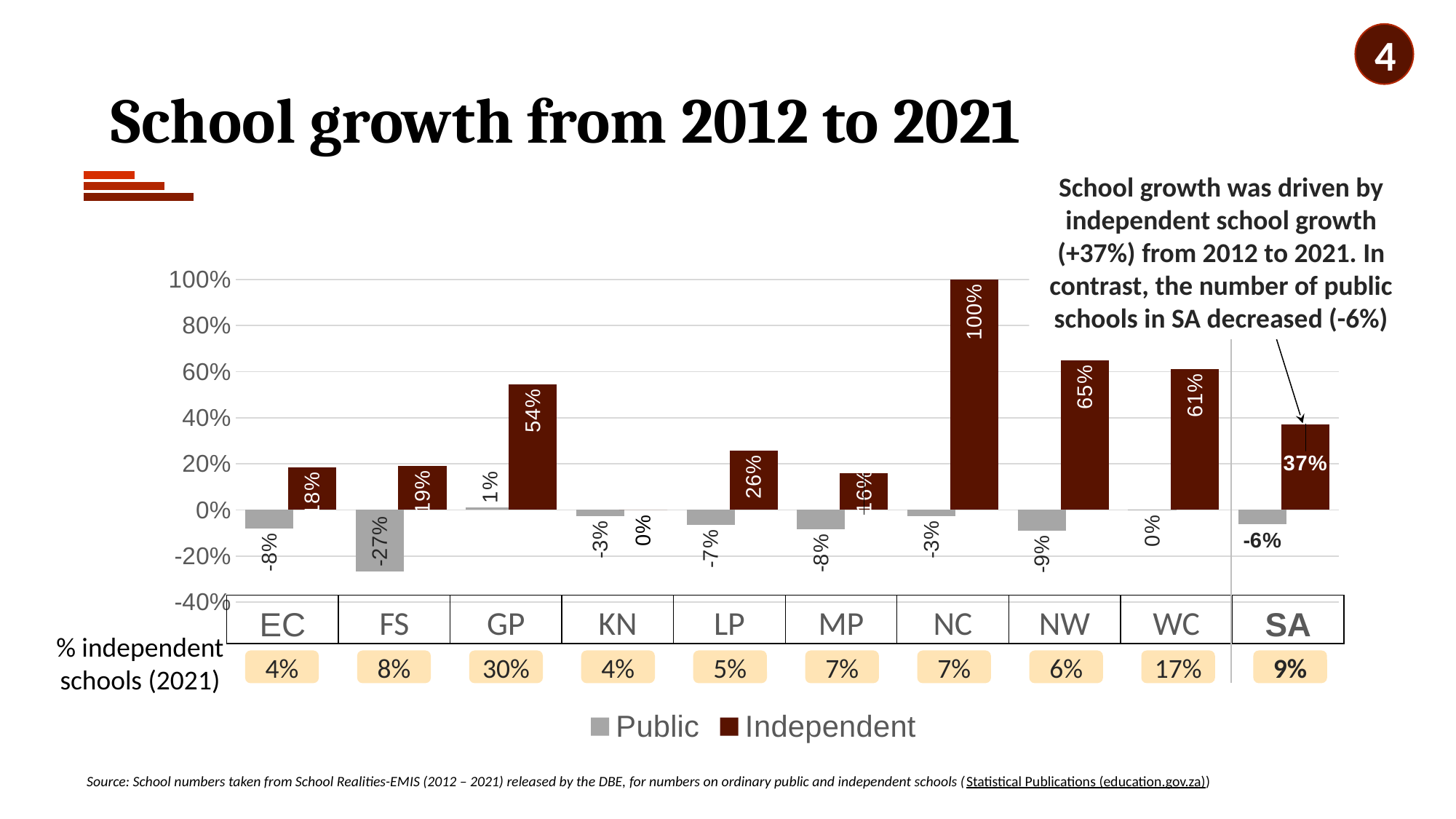
What is the Public value for FS? -27% What is the Public value for SA? -6% What is the Independent value for GP? 54% Which category has the highest Independent value? NC Which has the larger Independent value, GP or LP? GP What is the difference between the Independent values for NW and WC? 4 percentage points How many series does the chart legend list? 2 Which category has the lowest Public value? FS What are the two entries in the chart legend? Public and Independent What is the Independent value for NC? 100% What kind of chart is shown on the slide? Bar chart How many categories are shown along the x axis of the chart? 10